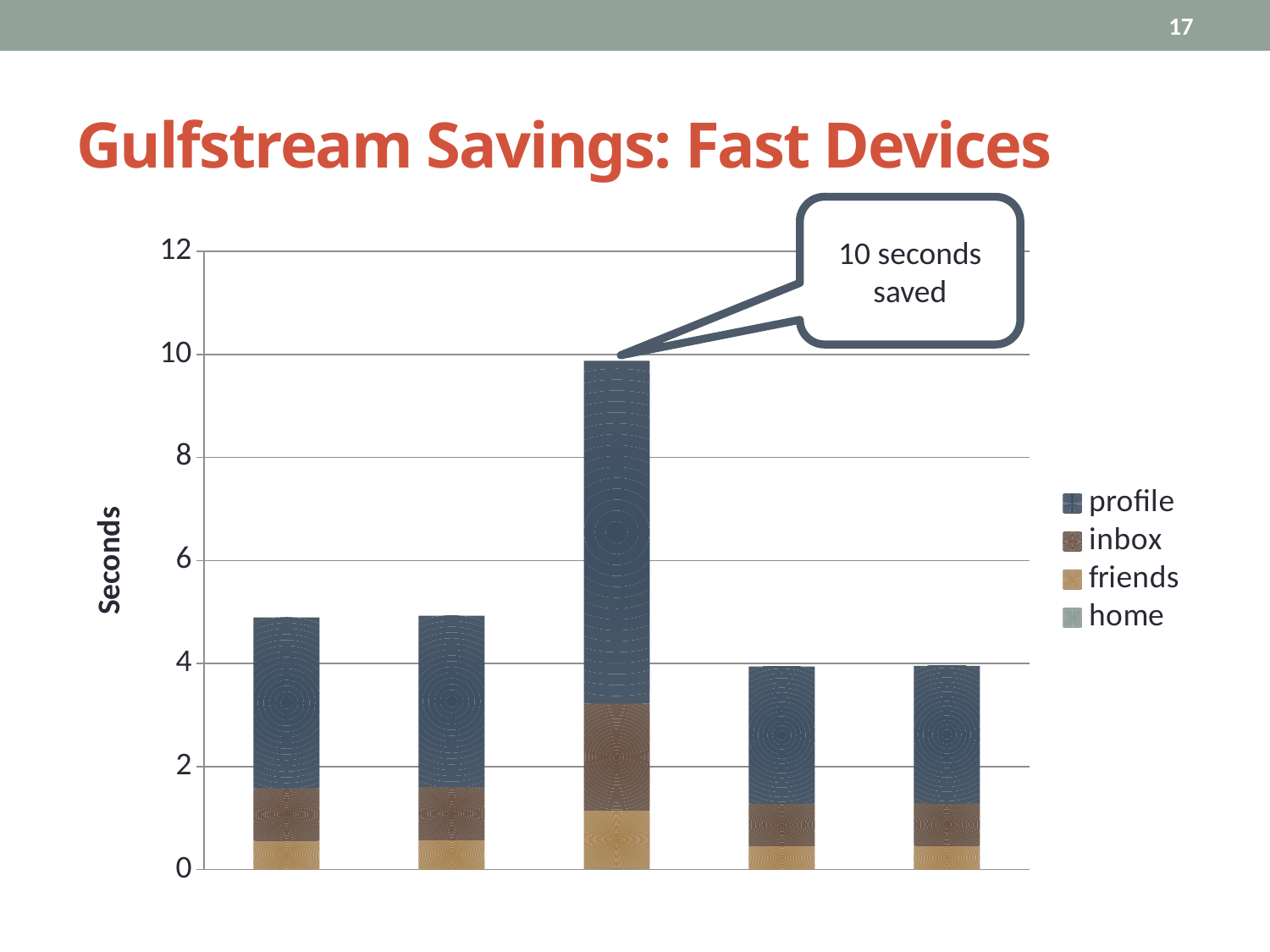
Which is taller, the third bar from the left or the fourth bar from the left? the third bar from the left What is the label on the vertical axis? Seconds Is the total height of the fifth bar from the left greater or less than 6 seconds? less Which series is listed first in the legend? profile What kind of chart is shown on the slide? stacked bar chart Is the total height of the first bar from the left greater or less than 6 seconds? less Is the total height of the first bar from the left greater or less than 4 seconds? greater How many series does the legend list? 4 Which bar is the tallest in the chart? the third bar from the left How many bars are plotted in the chart? 5